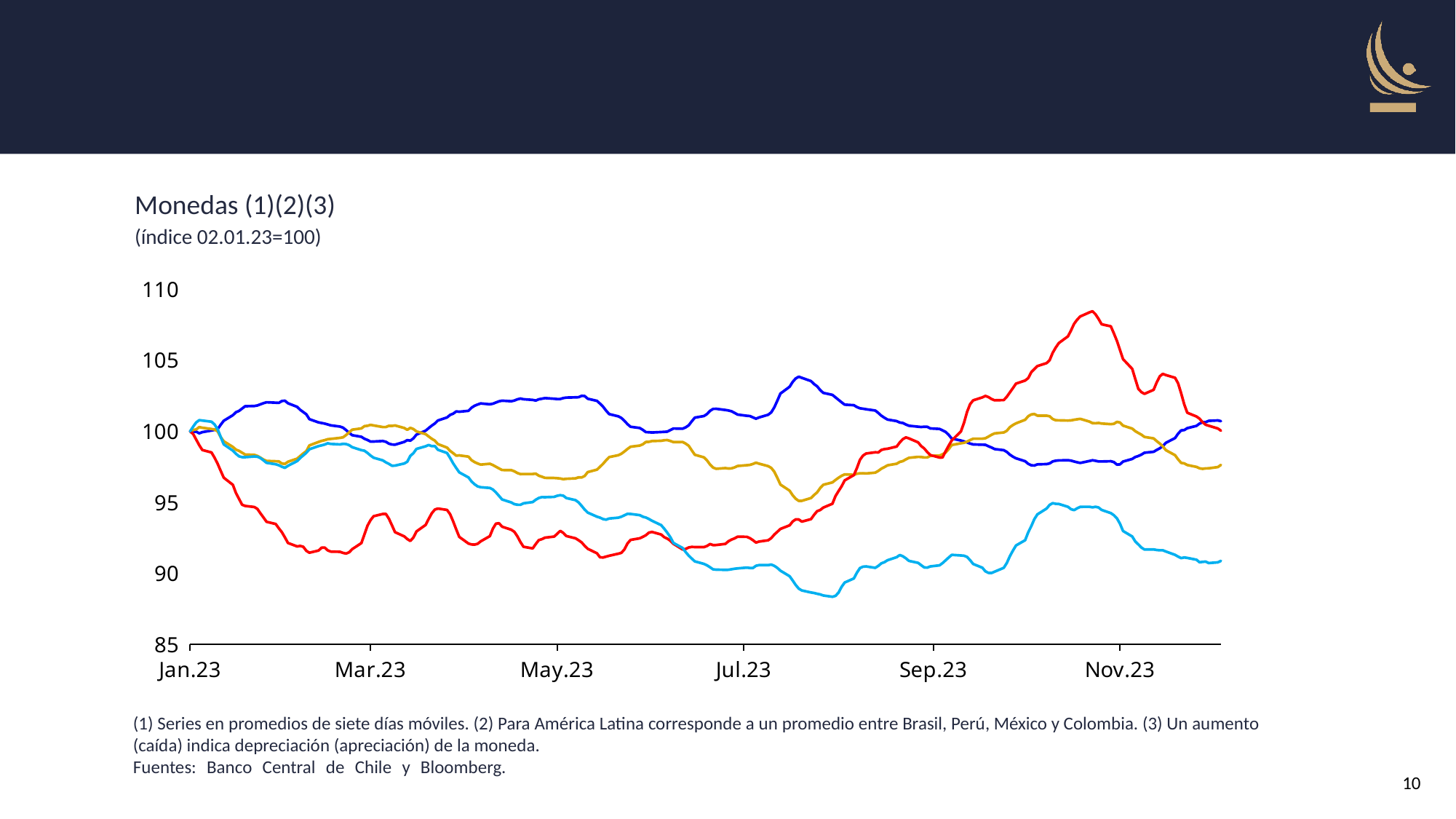
How many month labels are shown on the x axis? 6 Which coloured line reaches the highest value on the chart? Red Which coloured line reaches the lowest value on the chart? Light blue Is the value of the red line at Mar.23 greater or less than 95? less Is the lowest point of the light blue line, around Aug.23, greater or less than 90? less Does the light blue line rise or fall between Jan.23 and Jul.23? Falls Is the peak of the red line around Nov.23 greater or less than 105? greater How many lines are plotted in the chart? 4 What base is the index set to, according to the chart subtitle? 02.01.23=100 Does the red line rise or fall between Sep.23 and its peak near Nov.23? Rises What is the title of the chart? Monedas (1)(2)(3) What kind of chart is shown on the slide? Line chart